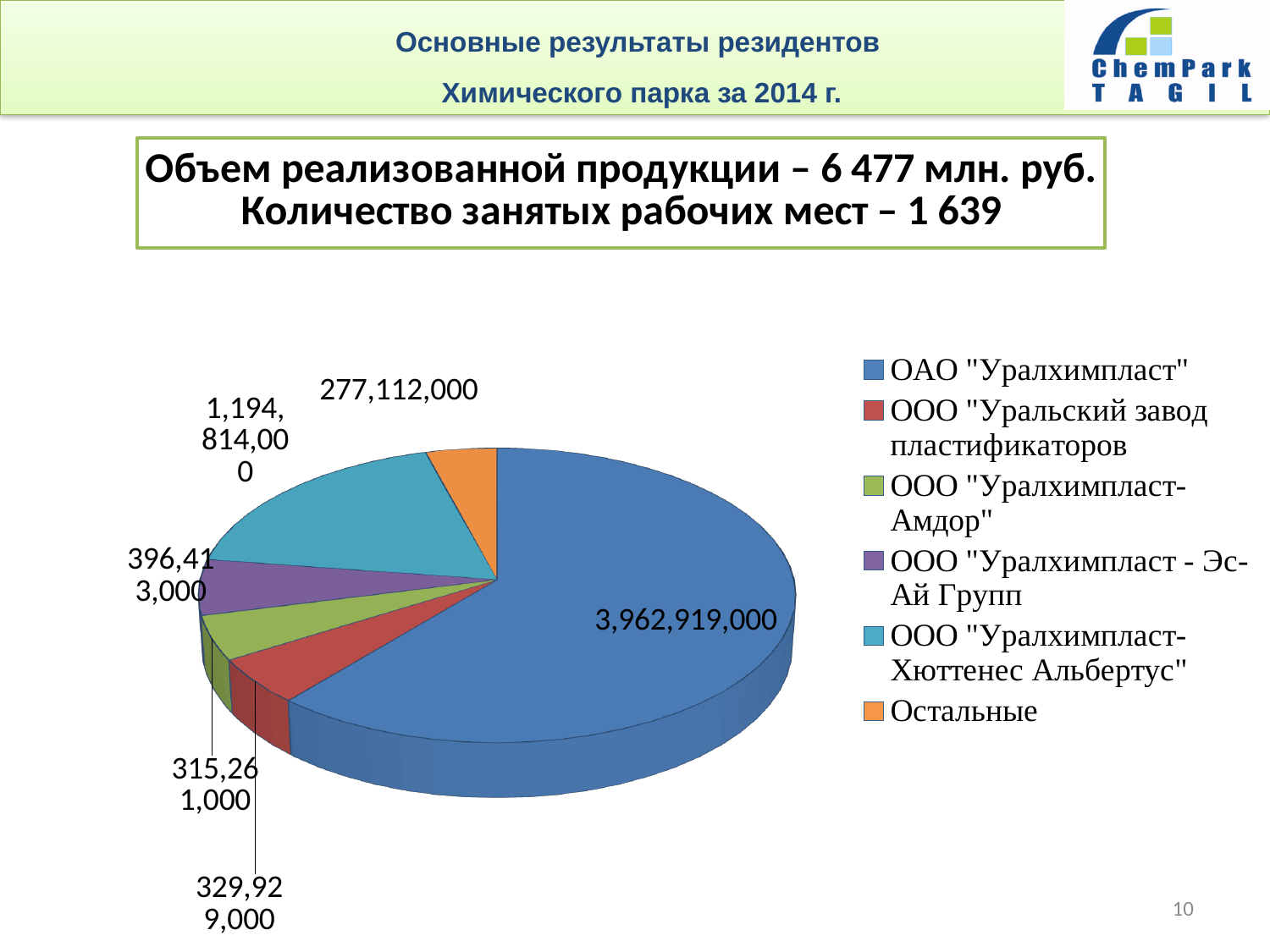
What is the value shown for ООО "Уралхимпласт-Хюттенес Альбертус"? 1,194,814,000 What kind of chart is shown on the slide? Pie chart Which company has the largest slice of the pie? ОАО "Уралхимпласт" What is the value shown for ООО "Уральский завод пластификаторов"? 329,929,000 What is the value shown for Остальные? 277,112,000 Which category has the smallest slice of the pie? Остальные What is the value shown for ОАО "Уралхимпласт"? 3,962,919,000 Which is larger, the value for ООО "Уральский завод пластификаторов" or the value for ООО "Уралхимпласт-Амдор"? ООО "Уральский завод пластификаторов" What is the value shown for ООО "Уралхимпласт - Эс-Ай Групп"? 396,413,000 How many slices does the pie chart have? 6 What is the difference between the values for ОАО "Уралхимпласт" and ООО "Уралхимпласт-Хюттенес Альбертус"? 2,768,105,000 What colour is the slice for ООО "Уралхимпласт-Хюттенес Альбертус"? Teal